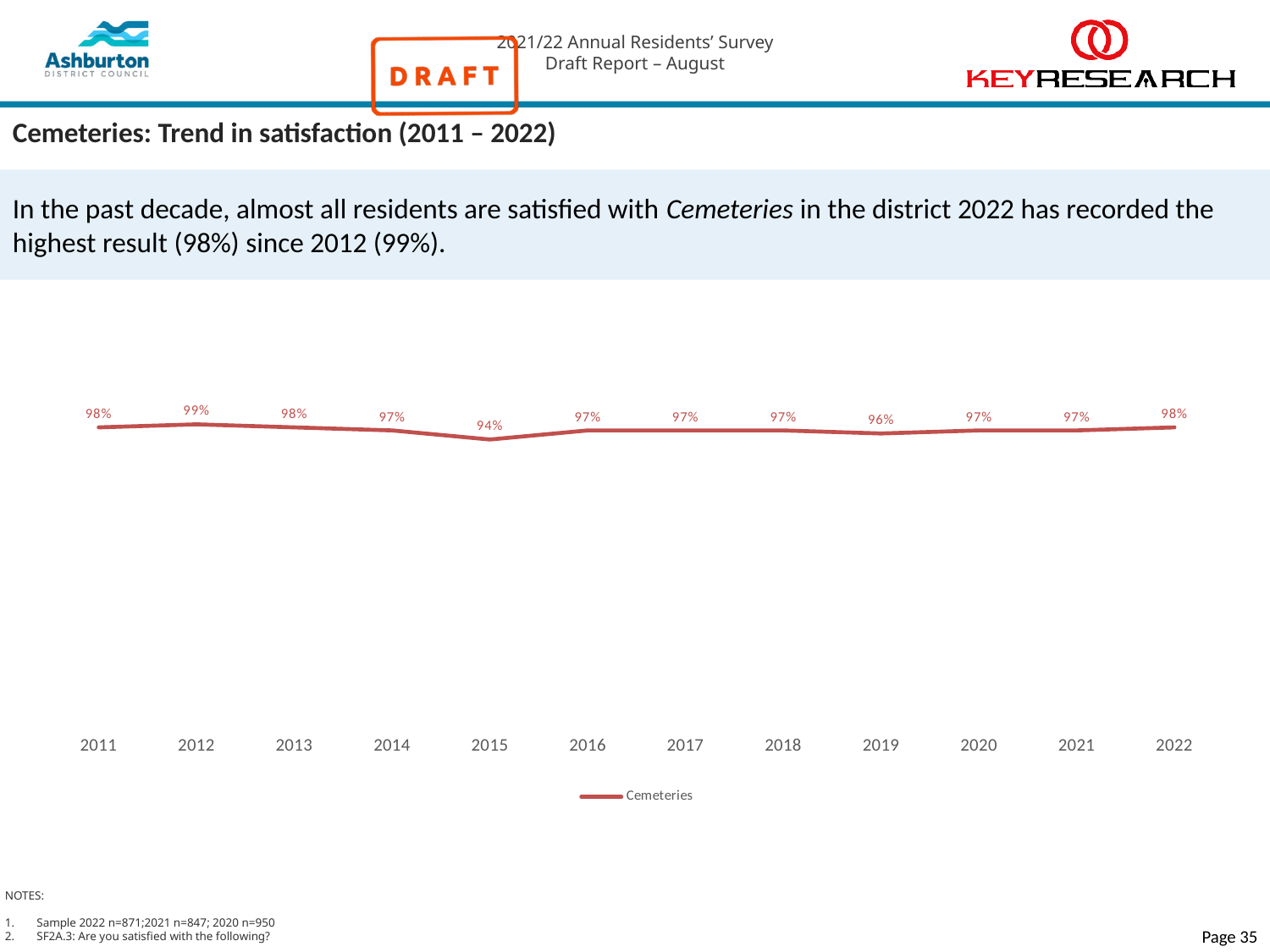
What series name is shown in the chart legend? Cemeteries How many years are plotted on the chart? 12 How many series does the legend list? 1 Which year has the highest satisfaction value for Cemeteries? 2012 Which year has a higher satisfaction value, 2019 or 2022? 2022 Does the satisfaction value rise or fall from 2019 to 2022? Rise What is the difference between the satisfaction values for 2012 and 2015? 5% What is the satisfaction value for Cemeteries in 2022? 98% What kind of chart is shown on the slide? Line chart What is the satisfaction value for Cemeteries in 2015? 94% Which year has the lowest satisfaction value for Cemeteries? 2015 What is the satisfaction value for Cemeteries in 2019? 96%